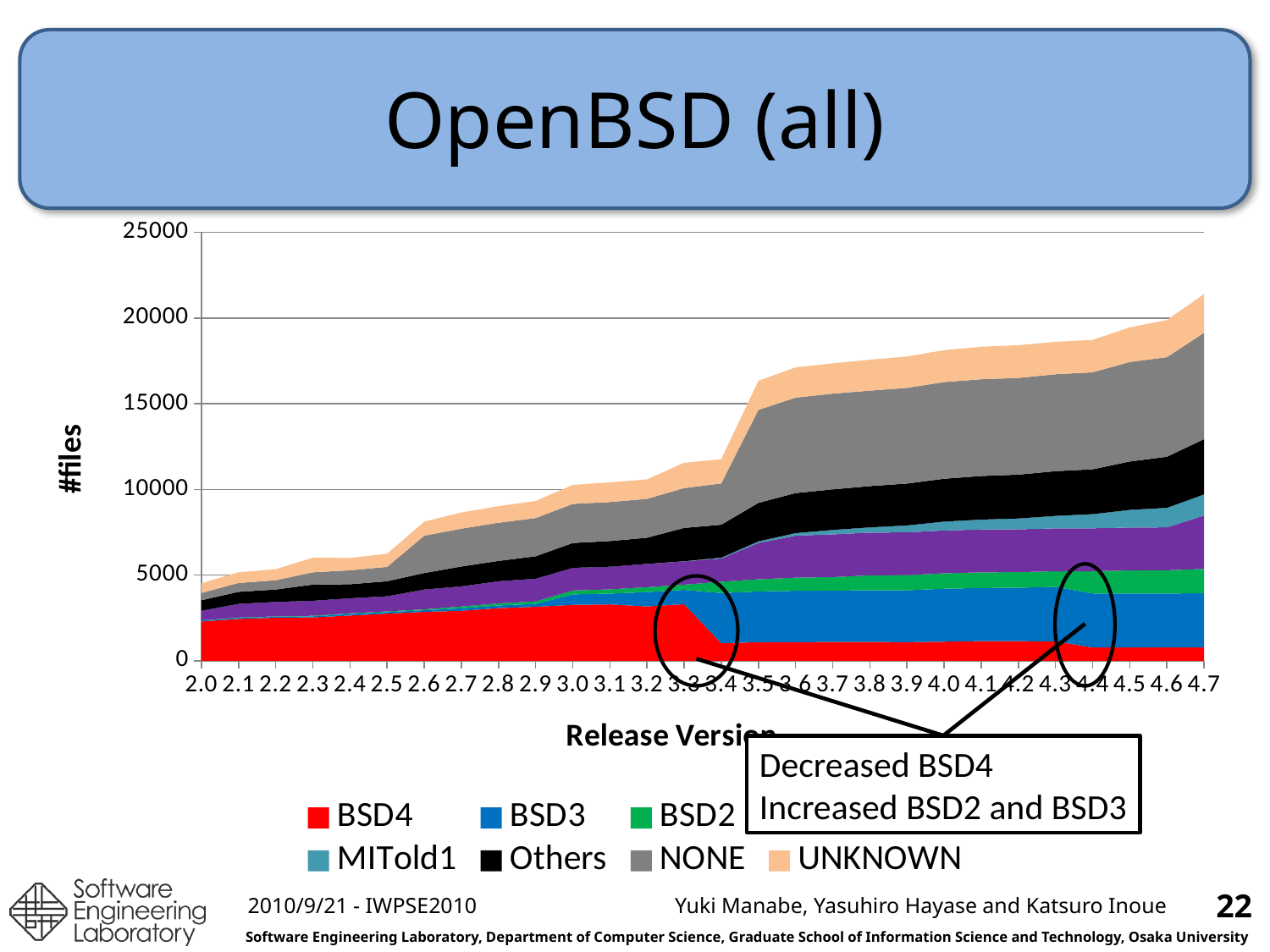
Is the total number of files for release 2.0 greater or less than 5000? less Is the total number of files for release 4.7 greater or less than 20000? greater Is the total number of files for release 3.5 greater or less than 15000? greater Which release version has the highest total number of files? 4.7 Does the total number of files generally rise or fall from release 2.0 to release 4.7? rise Is the BSD4 value larger at release 3.3 or at release 3.4? 3.3 How many release versions are shown along the x axis? 28 What kind of chart is shown on the slide? Stacked area chart Which release version has the lowest total number of files? 2.0 What is the title of the x axis? Release Version What colour represents the BSD4 series? Red